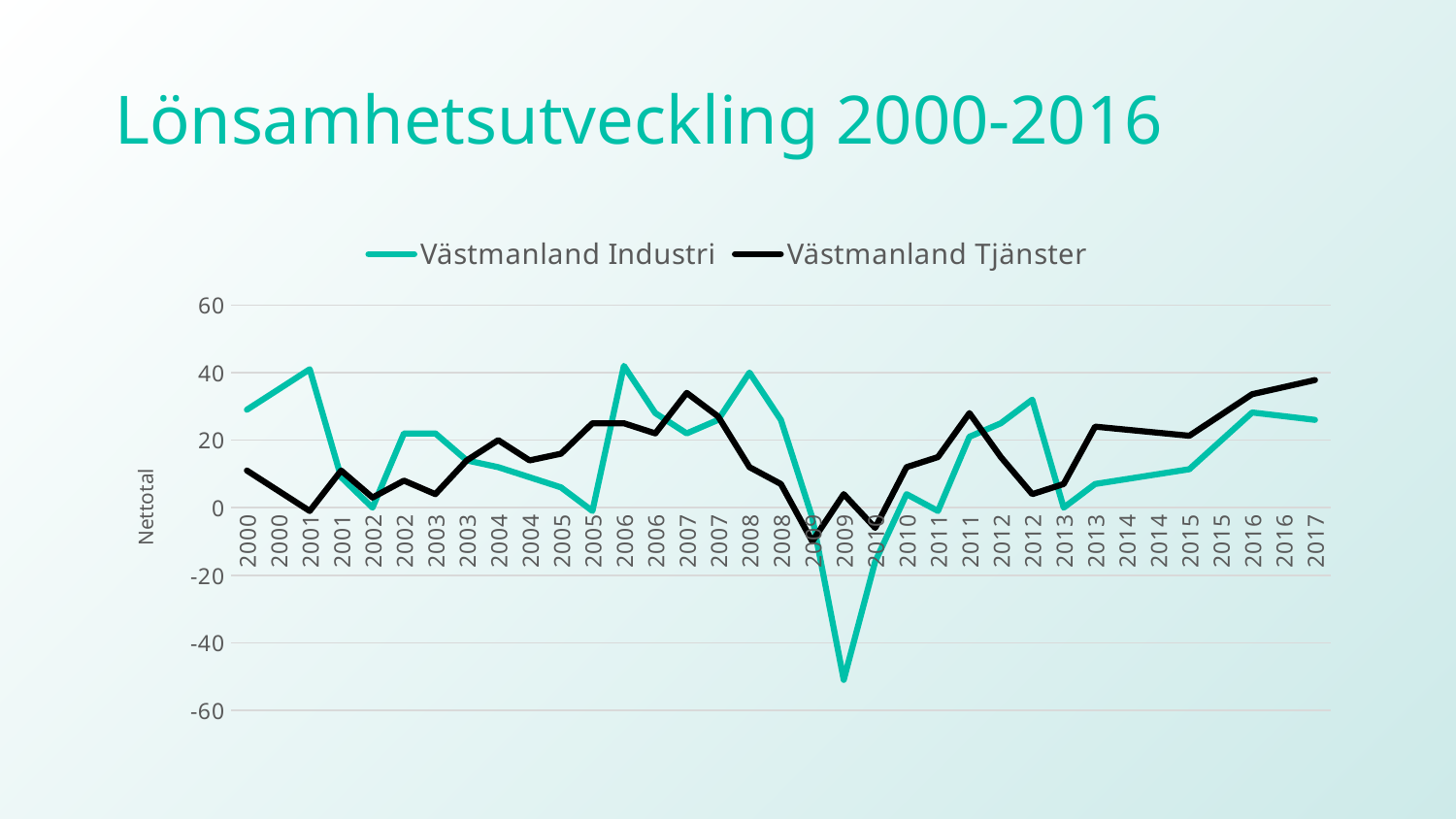
At 2017, which series has the higher value, Västmanland Industri or Västmanland Tjänster? Västmanland Tjänster Is the value for Västmanland Tjänster at 2017 greater or less than 20? greater Is the value for Västmanland Industri at the first 2000 point greater or less than 20? greater At the first 2000 point, which series has the higher value, Västmanland Industri or Västmanland Tjänster? Västmanland Industri What is the label on the vertical axis? Nettotal In which year does the Västmanland Industri series reach its lowest value? 2009 What kind of chart is shown on the slide? line chart How many series does the legend list? 2 What is the title of the chart on the slide? Lönsamhetsutveckling 2000-2016 Is the value for Västmanland Tjänster at the first 2000 point greater or less than 20? less Does the Västmanland Tjänster series rise or fall between 2013 and 2017? rise